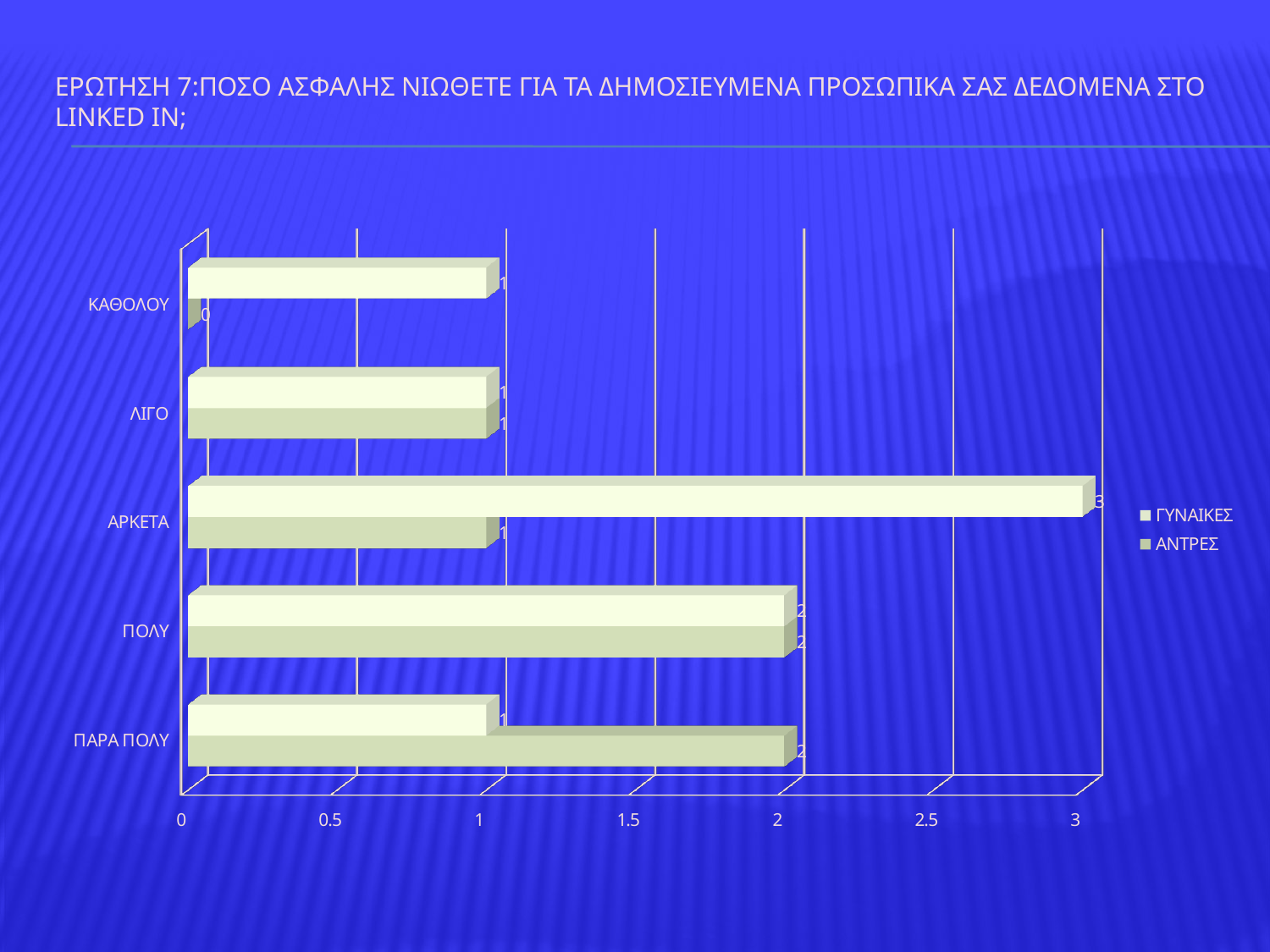
What kind of chart is shown on the slide? Bar chart Which series is shown in the lighter colour according to the legend? ΓΥΝΑΙΚΕΣ What is the value for ΓΥΝΑΙΚΕΣ in the ΑΡΚΕΤΑ category? 3 What is the value for ΓΥΝΑΙΚΕΣ in the ΠΟΛΥ category? 2 What is the value for ΑΝΤΡΕΣ in the ΚΑΘΟΛΟΥ category? 0 How many categories are shown on the chart? 5 How many series does the legend list? 2 Which category has the highest value for ΓΥΝΑΙΚΕΣ? ΑΡΚΕΤΑ Which category has the lowest value for ΑΝΤΡΕΣ? ΚΑΘΟΛΟΥ What is the difference between the ΓΥΝΑΙΚΕΣ and ΑΝΤΡΕΣ values in the ΑΡΚΕΤΑ category? 2 What is the value for ΑΝΤΡΕΣ in the ΠΑΡΑ ΠΟΛΥ category? 2 In the ΠΑΡΑ ΠΟΛΥ category, which series has the larger value, ΓΥΝΑΙΚΕΣ or ΑΝΤΡΕΣ? ΑΝΤΡΕΣ